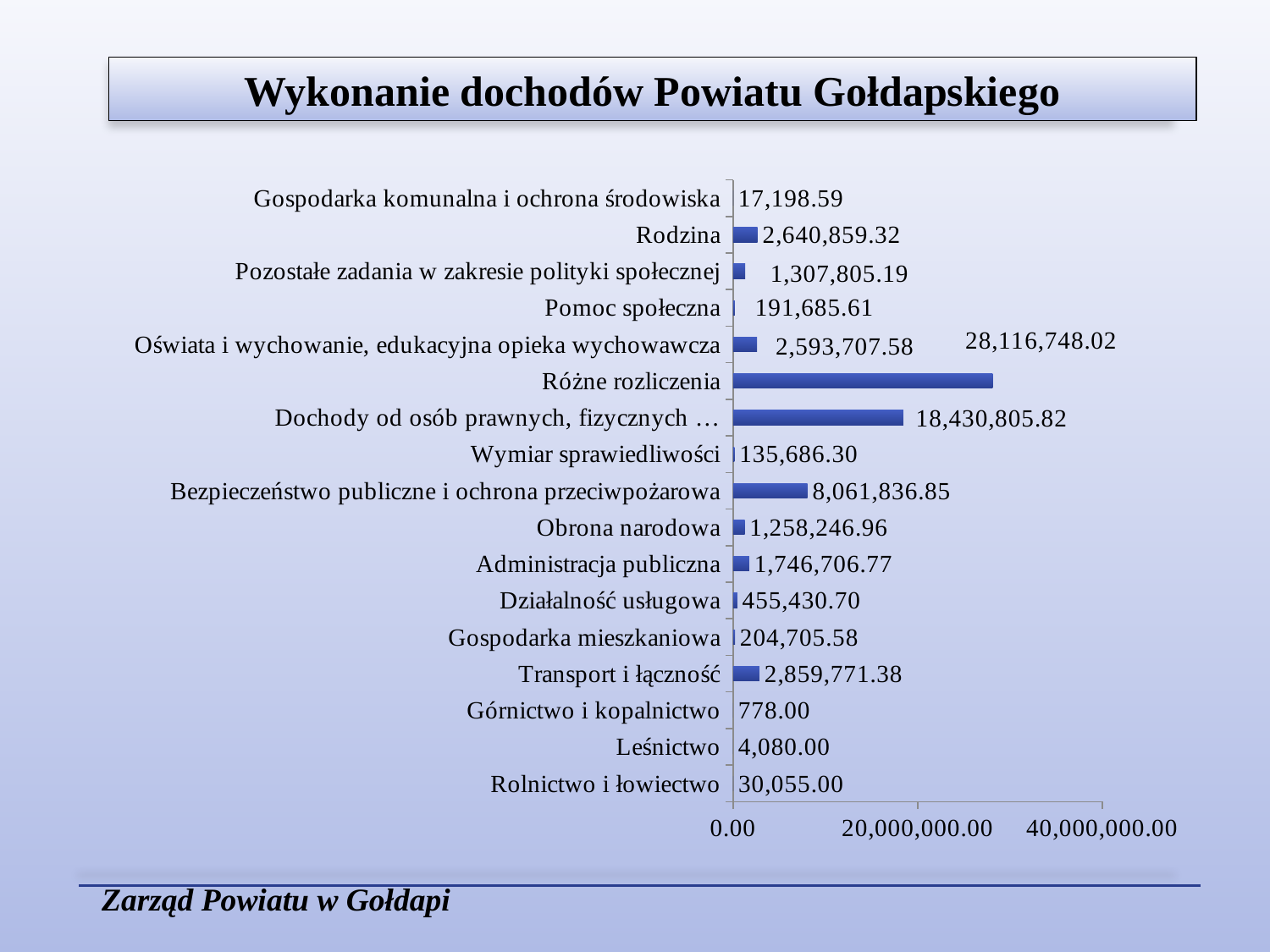
What is the value for Transport i łączność? 2,859,771.38 What is the value for Leśnictwo? 4,080.00 Which category has the lowest value? Górnictwo i kopalnictwo How many categories are shown in the chart? 17 What is the value for Bezpieczeństwo publiczne i ochrona przeciwpożarowa? 8,061,836.85 What is the difference between the values for Różne rozliczenia and Dochody od osób prawnych, fizycznych …? 9,685,942.20 Is the value for Różne rozliczenia greater or less than 20,000,000.00? greater Which category has the highest value? Różne rozliczenia What is the value for Różne rozliczenia? 28,116,748.02 What kind of chart is shown on the slide? bar chart What is the title of the slide? Wykonanie dochodów Powiatu Gołdapskiego Which is larger, the value for Bezpieczeństwo publiczne i ochrona przeciwpożarowa or the value for Administracja publiczna? Bezpieczeństwo publiczne i ochrona przeciwpożarowa